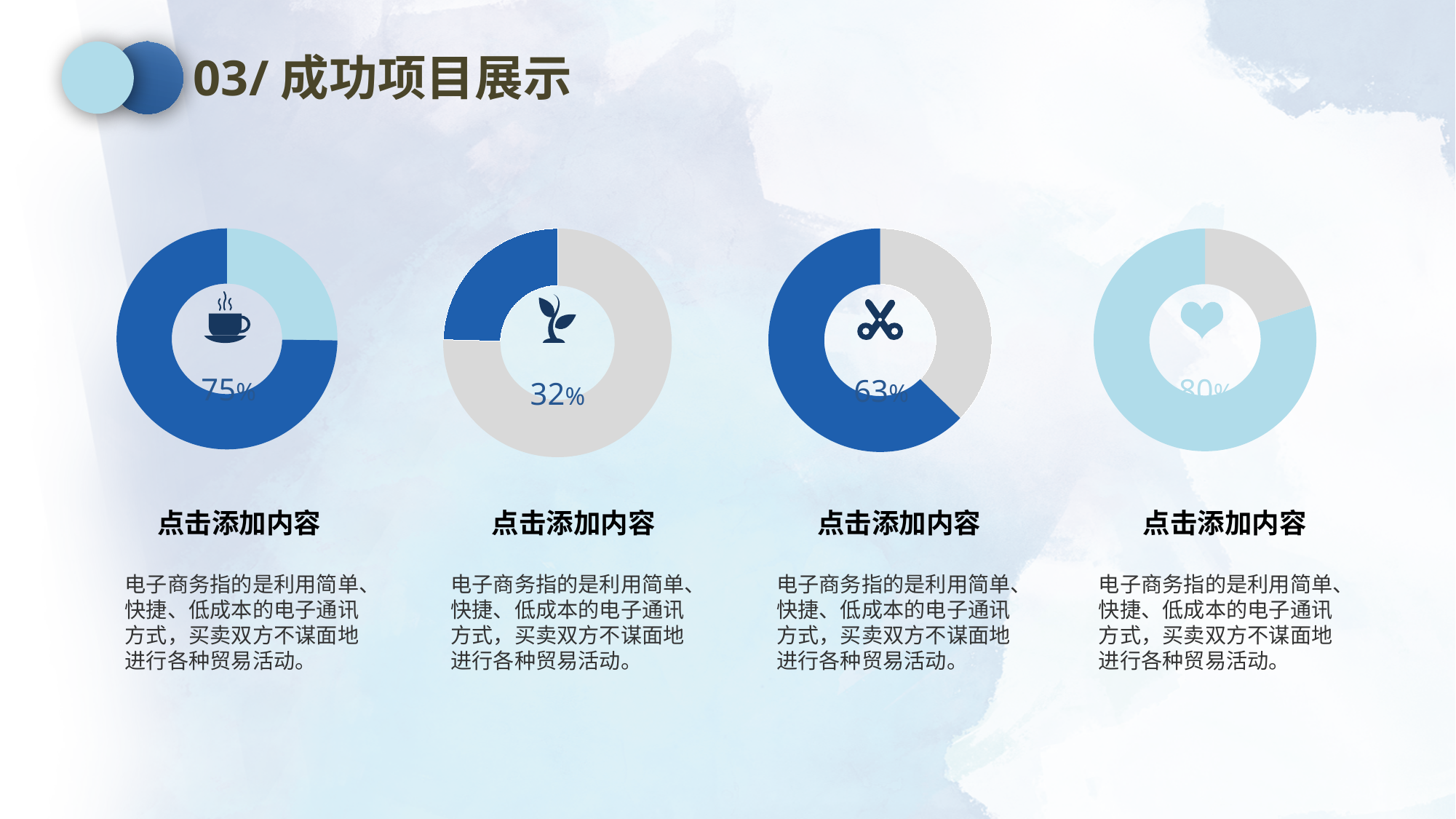
Which of the four doughnut charts shows the lowest percentage? The second chart from the left (sprout icon), 32% What percentage is shown in the rightmost doughnut chart (with the heart icon)? 80% Which is larger: the percentage in the leftmost chart (coffee cup) or the third chart (scissors)? The leftmost chart (75%) What is the difference between the percentage in the rightmost chart and the percentage in the leftmost chart? 5% How many doughnut charts are on the slide? 4 What percentage is shown in the third doughnut chart from the left (with the scissors icon)? 63% What kind of chart is used for each of the four figures on the slide? Doughnut chart What is the difference between the percentage in the third chart (scissors icon) and the second chart (sprout icon)? 31% What is the section title at the top of the slide? 03/ 成功项目展示 What percentage is shown in the second doughnut chart from the left (with the sprout icon)? 32% Which of the four doughnut charts shows the highest percentage? The rightmost chart (heart icon), 80% What percentage is shown in the leftmost doughnut chart (with the coffee cup icon)? 75%